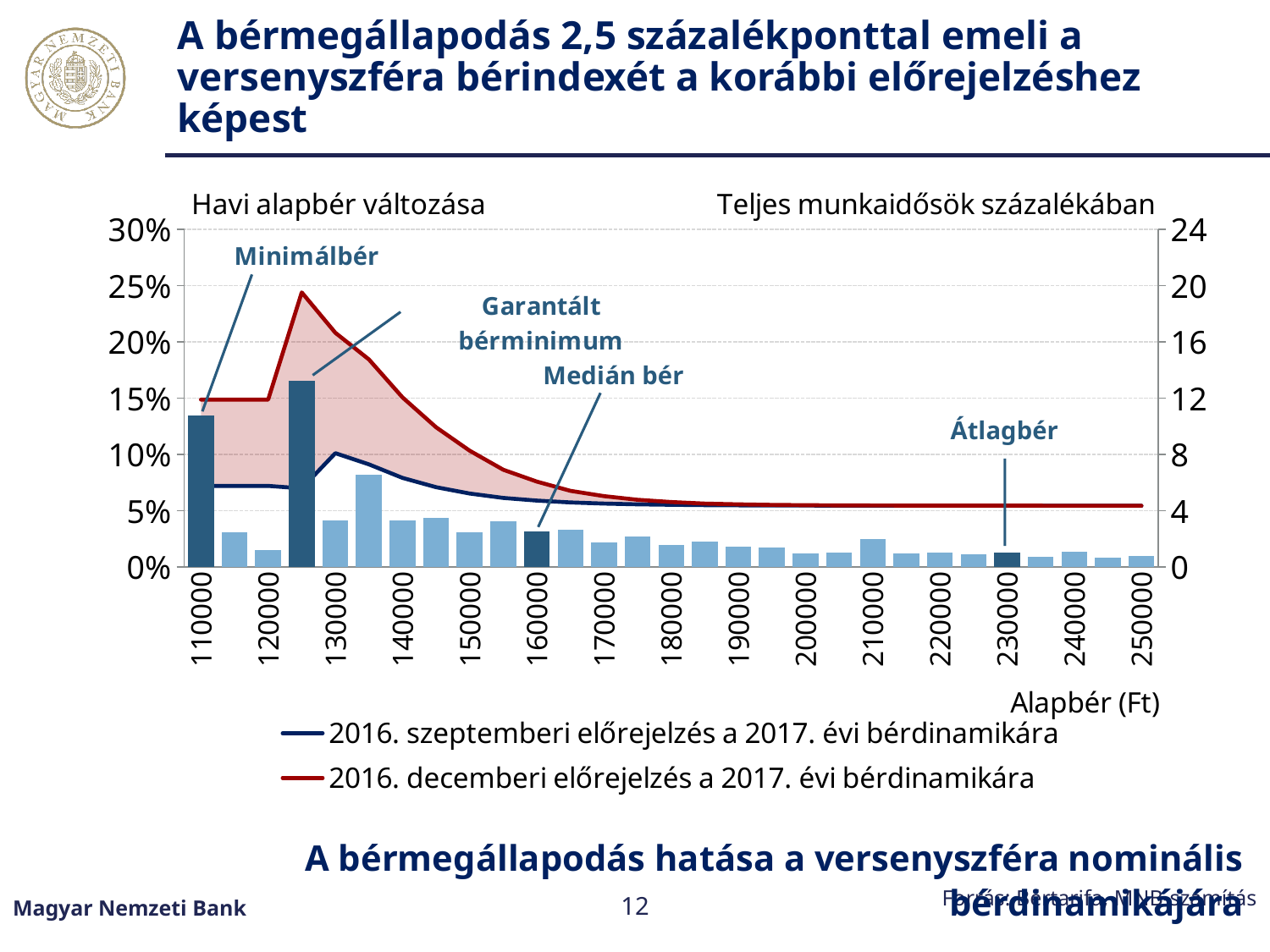
At 125000 Ft, which line is higher: the 2016. szeptemberi or the 2016. decemberi előrejelzés? 2016. decemberi előrejelzés Is the value of the red line (2016. decemberi előrejelzés) at 125000 greater or less than 20%? greater How many labelled tick values are shown on the x axis? 15 How many series does the legend list? 2 Is the value of the red line (2016. decemberi előrejelzés) at 160000 greater or less than 10%? less Which annotation label points to the bar at 230000? Átlagbér Is the value of the navy line (2016. szeptemberi előrejelzés) at 125000 greater or less than 10%? less What is the title of the x axis? Alapbér (Ft) What kind of chart is this? A combination chart with bars and lines Does the red line (2016. decemberi előrejelzés) rise or fall from 130000 to 250000? fall